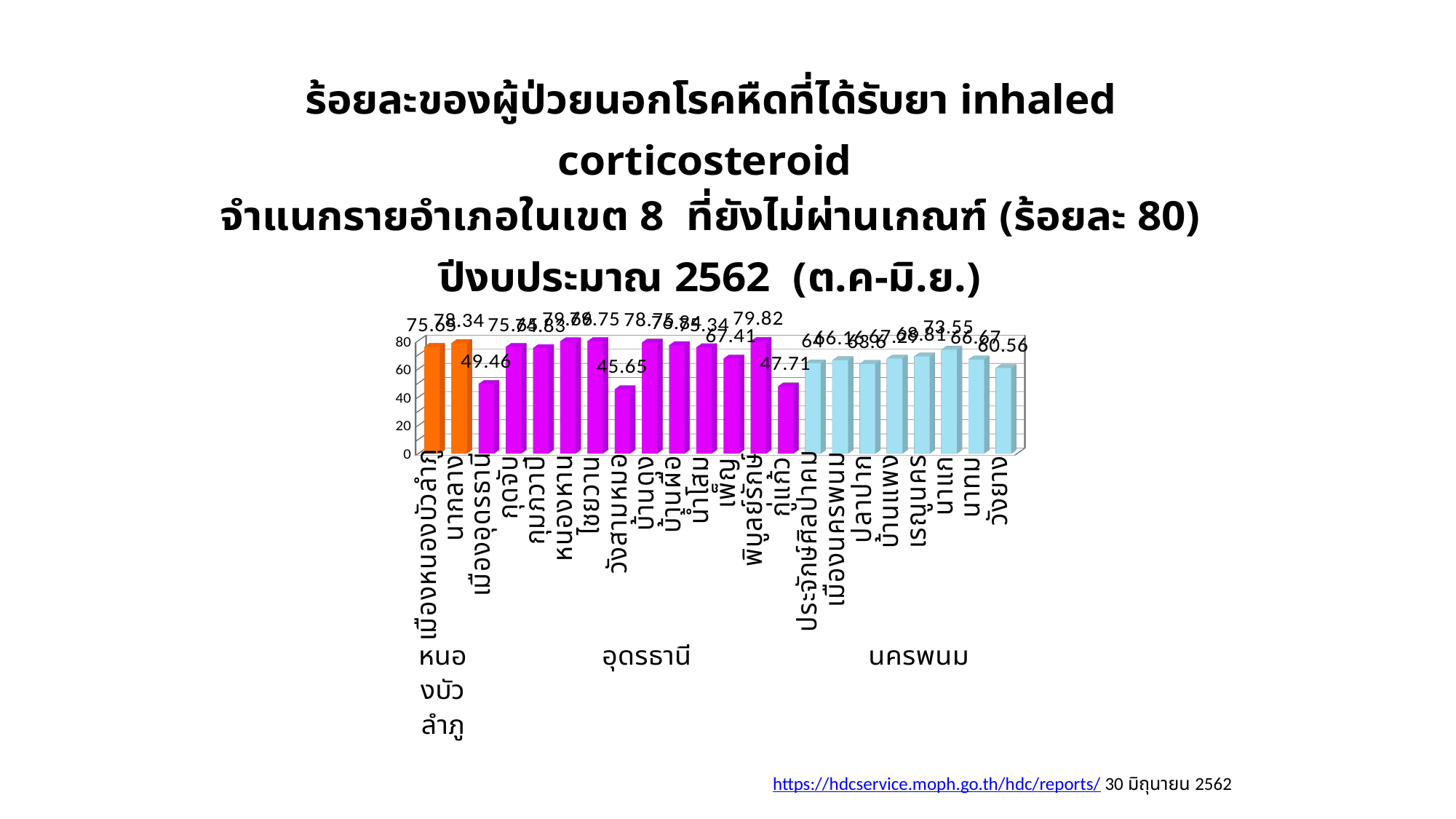
Is the value for กุมภวาปี greater or less than 60? greater What is the value for วังยาง? 60.56 Which is larger, the value for เมืองอุดรธานี or the value for กู่แก้ว? เมืองอุดรธานี Which district has the highest value among the นครพนม group? นาแก What kind of chart is shown on the slide? bar chart What is the value for เมืองอุดรธานี? 49.46 How many province groups are labelled along the x axis? 3 Which district has the lowest value in the chart? วังสามหมอ What is the value for พิบูลย์รักษ์? 79.82 What is the difference between the values for นากลาง and เมืองหนองบัวลำภู? 2.69 What is the value for วังสามหมอ? 45.65 What is the value for นาแก? 73.55